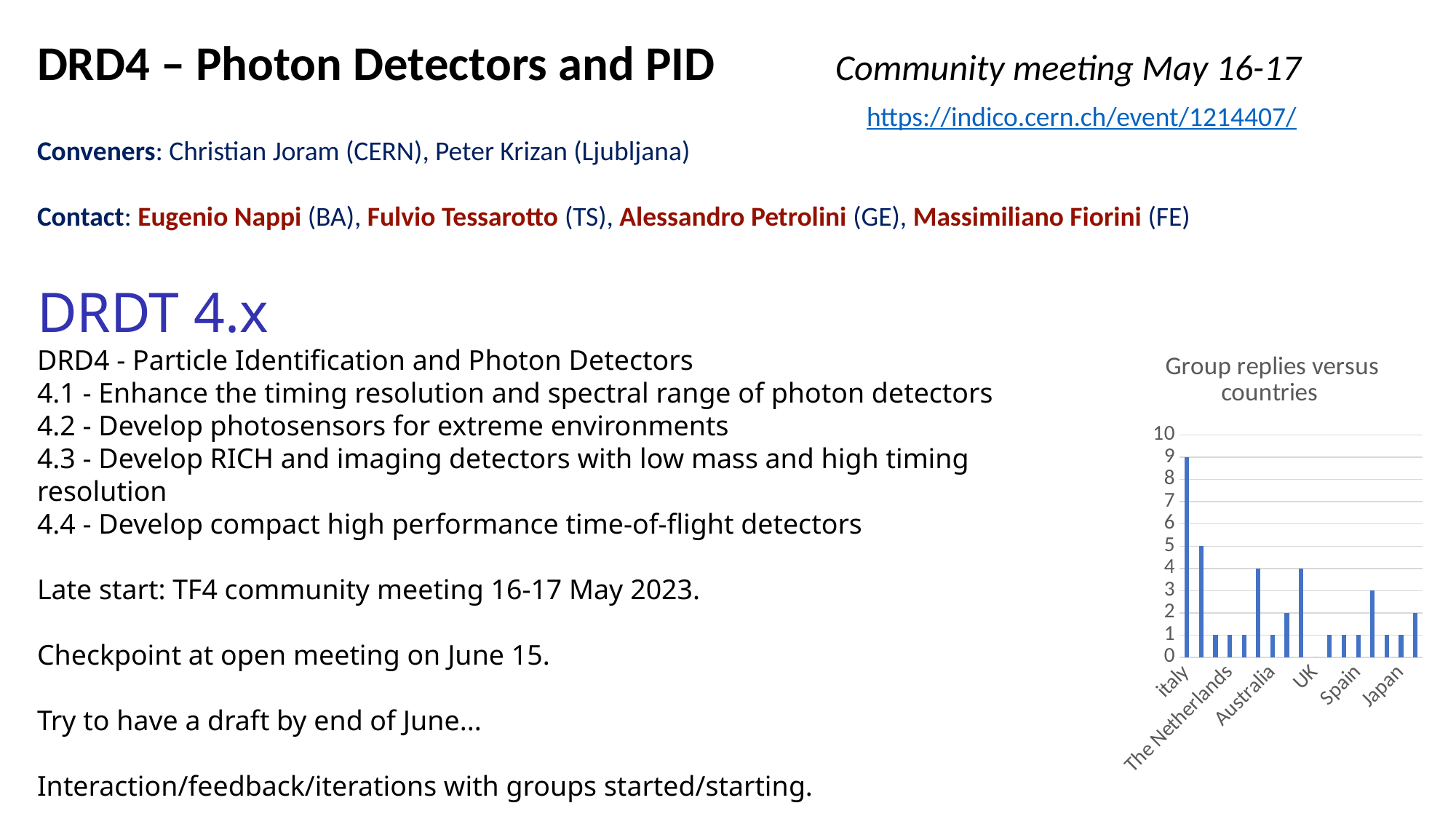
What is the title of the chart on the slide? Group replies versus countries How many group replies does the chart show for italy? 9 Which country has the highest number of group replies in the chart? italy What is the maximum value shown on the vertical axis of the chart? 10 What kind of chart is shown on the slide? bar chart Is the value for italy greater or less than 5? greater Is the value for Japan greater or less than 5? less Is the value for Spain greater or less than 5? less Which has more group replies, italy or Japan? italy